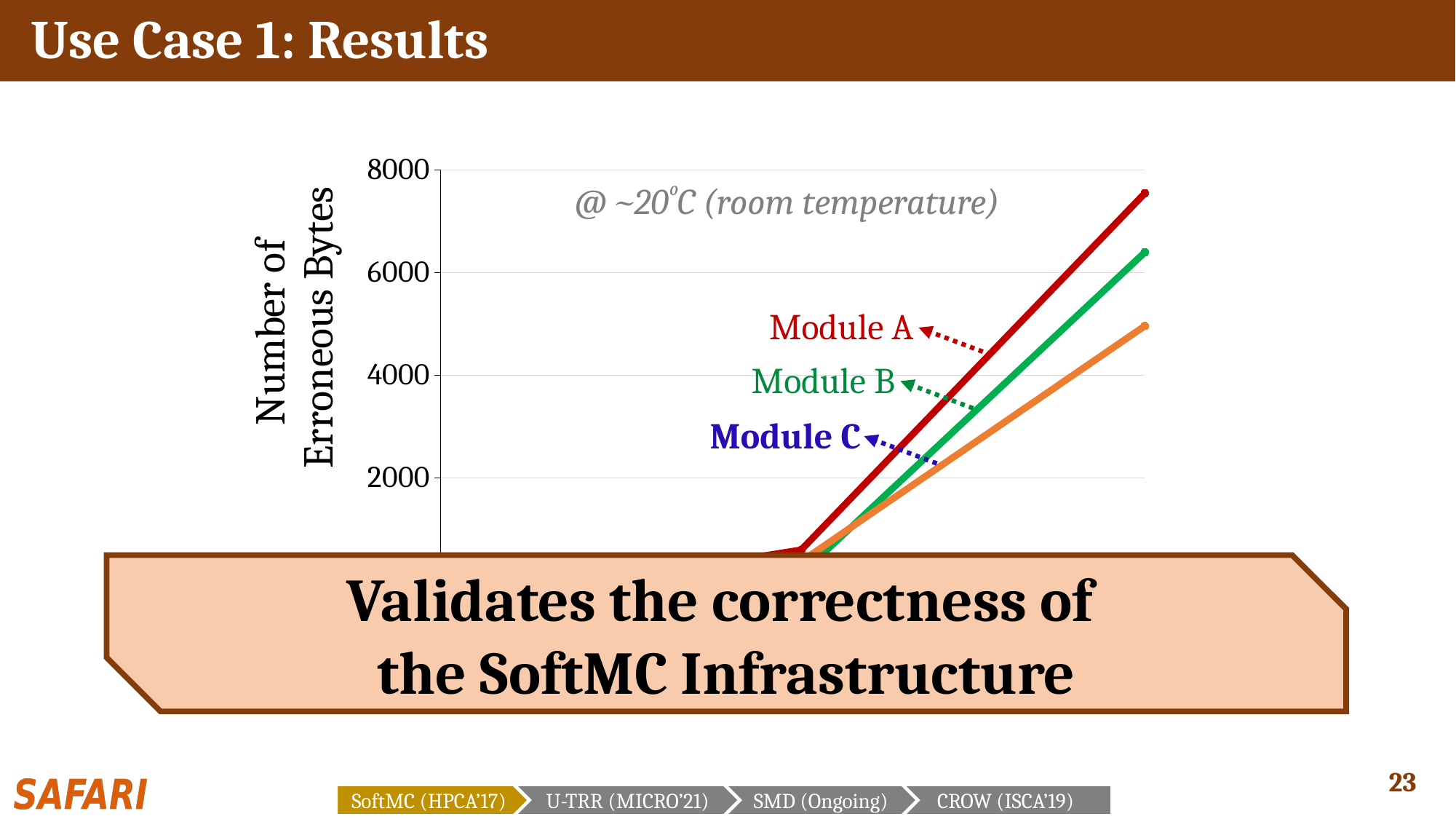
Do the number of erroneous bytes for the modules rise or fall toward the right side of the chart? rise Which module reaches the highest number of erroneous bytes at the right end of the chart? Module A At the right end of the chart, is the number of erroneous bytes for Module C greater or less than 4000? greater At the right end of the chart, is the number of erroneous bytes for Module C greater or less than 6000? less Which module has the lowest number of erroneous bytes at the right end of the chart? Module C At the right end of the chart, is the number of erroneous bytes for Module A greater or less than 6000? greater What kind of chart is shown on the slide? line chart At what temperature does the chart annotation say the results were measured? ~20°C (room temperature) How many modules (series) are plotted in the chart? 3 What is the label of the y-axis of the chart? Number of Erroneous Bytes At the right end of the chart, which has more erroneous bytes, Module B or Module C? Module B